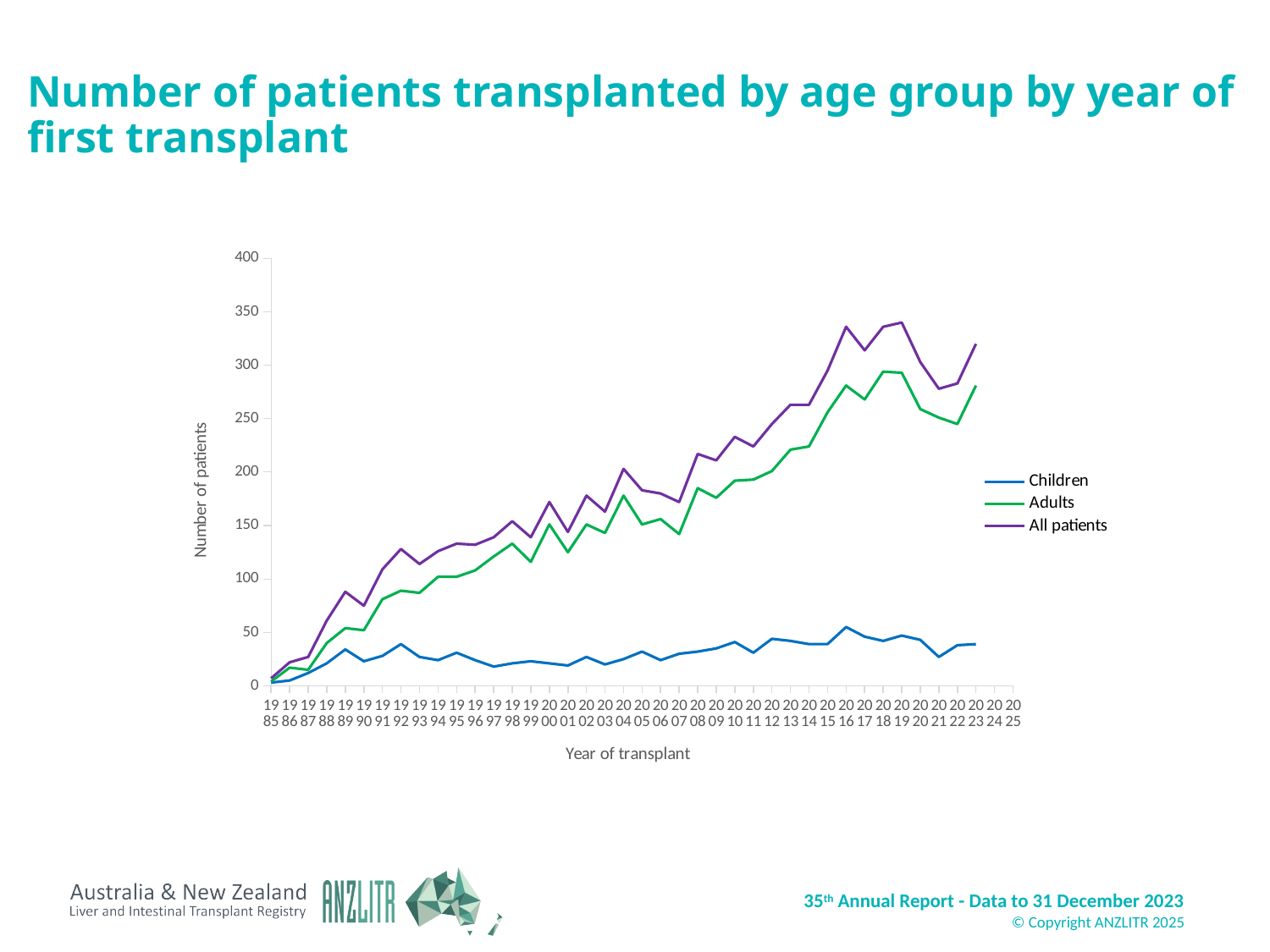
Which series reaches the highest value on the chart? All patients Is the value for Children in 2016 greater or less than 100? less Is the value for All patients in 2019 greater or less than 300? greater Is the value for All patients in 1985 greater or less than 50? less In 2016, which is larger: the value for Adults or the value for Children? Adults What is the title of the x axis? Year of transplant How many series does the legend list? 3 Which series has the lowest values across all years? Children What kind of chart is shown on the slide? Line chart Does the All patients line generally rise or fall from 1985 to 2019? rise What is the title of the y axis? Number of patients